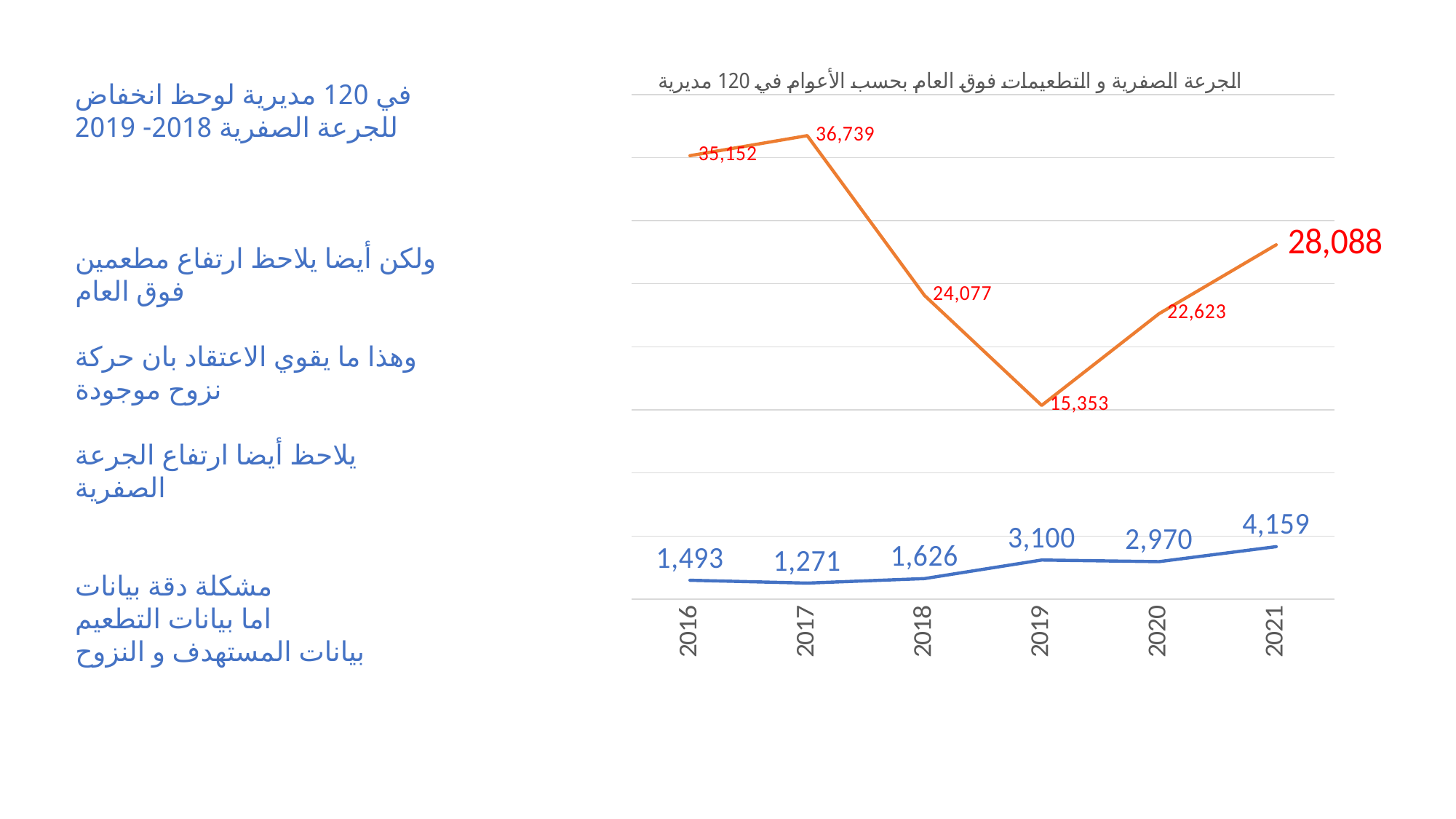
What kind of chart is shown on the slide? line chart What is the value of the blue line in 2021? 4,159 What is the difference between the orange line's values in 2017 and 2019? 21,386 How many years are plotted along the x axis of the chart? 6 What is the value of the orange line in 2019? 15,353 In which year does the orange line reach its highest value? 2017 What is the difference between the blue line's values in 2021 and 2016? 2,666 In which year does the blue line reach its lowest value? 2017 Which is larger for the blue line: the value in 2019 or the value in 2020? 2019 In which year does the orange line reach its lowest value? 2019 What is the value of the orange line in 2017? 36,739 Does the orange line rise or fall from 2019 to 2021? rise